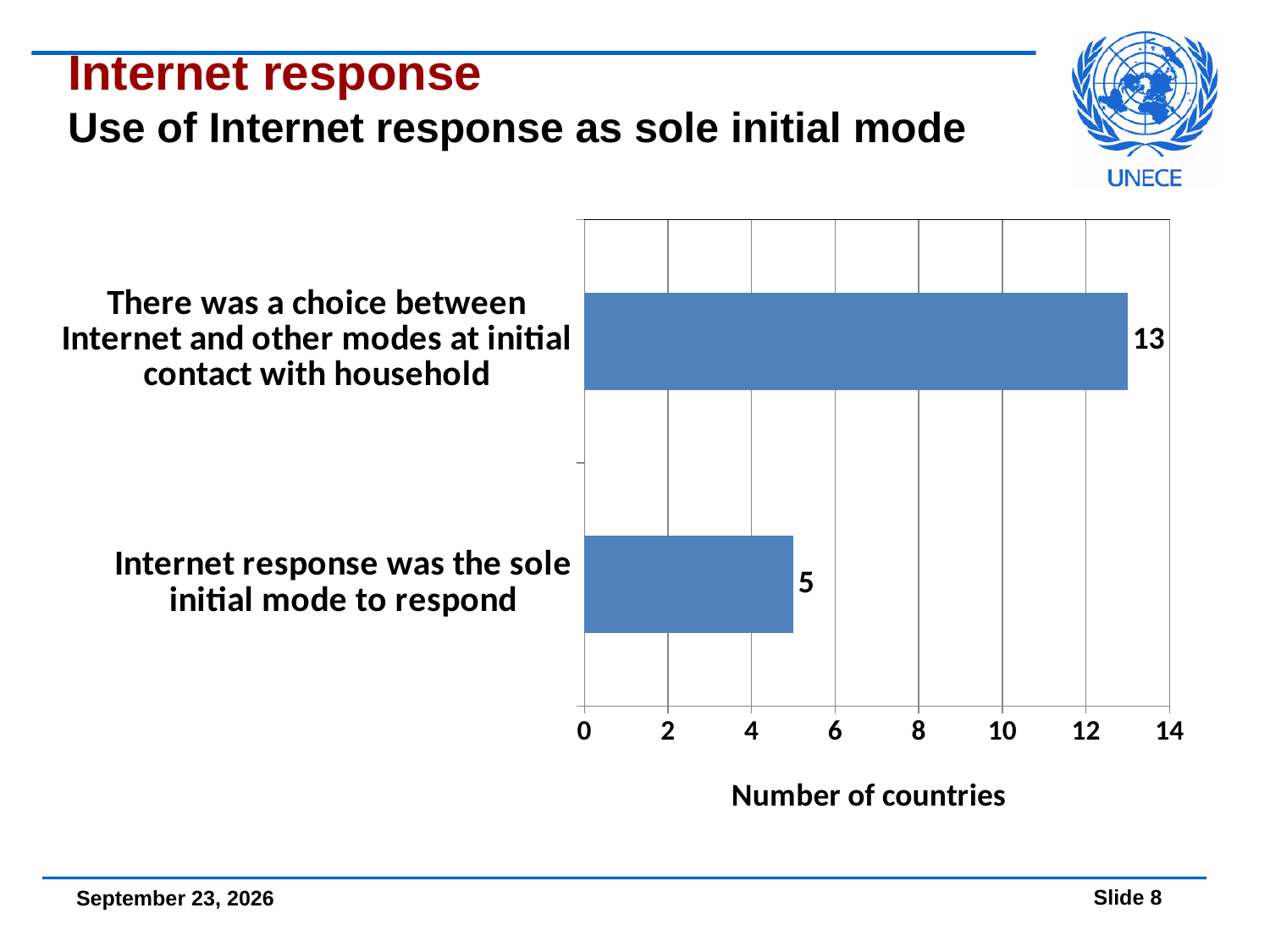
Which category has the highest number of countries? There was a choice between Internet and other modes at initial contact with household How many countries had Internet response as the sole initial mode to respond? 5 What is the maximum value shown on the horizontal axis? 14 Is the value for 'There was a choice between Internet and other modes at initial contact with household' greater or less than 10? greater Is the value for 'Internet response was the sole initial mode to respond' greater or less than 6? less What is the difference in the number of countries between the two categories? 8 Which category has the lowest number of countries? Internet response was the sole initial mode to respond What is the label of the horizontal axis? Number of countries Which category has more countries: 'Internet response was the sole initial mode to respond' or 'There was a choice between Internet and other modes at initial contact with household'? There was a choice between Internet and other modes at initial contact with household What type of chart is shown on the slide? Bar chart How many categories are shown in the chart? 2 How many countries had a choice between Internet and other modes at initial contact with household? 13